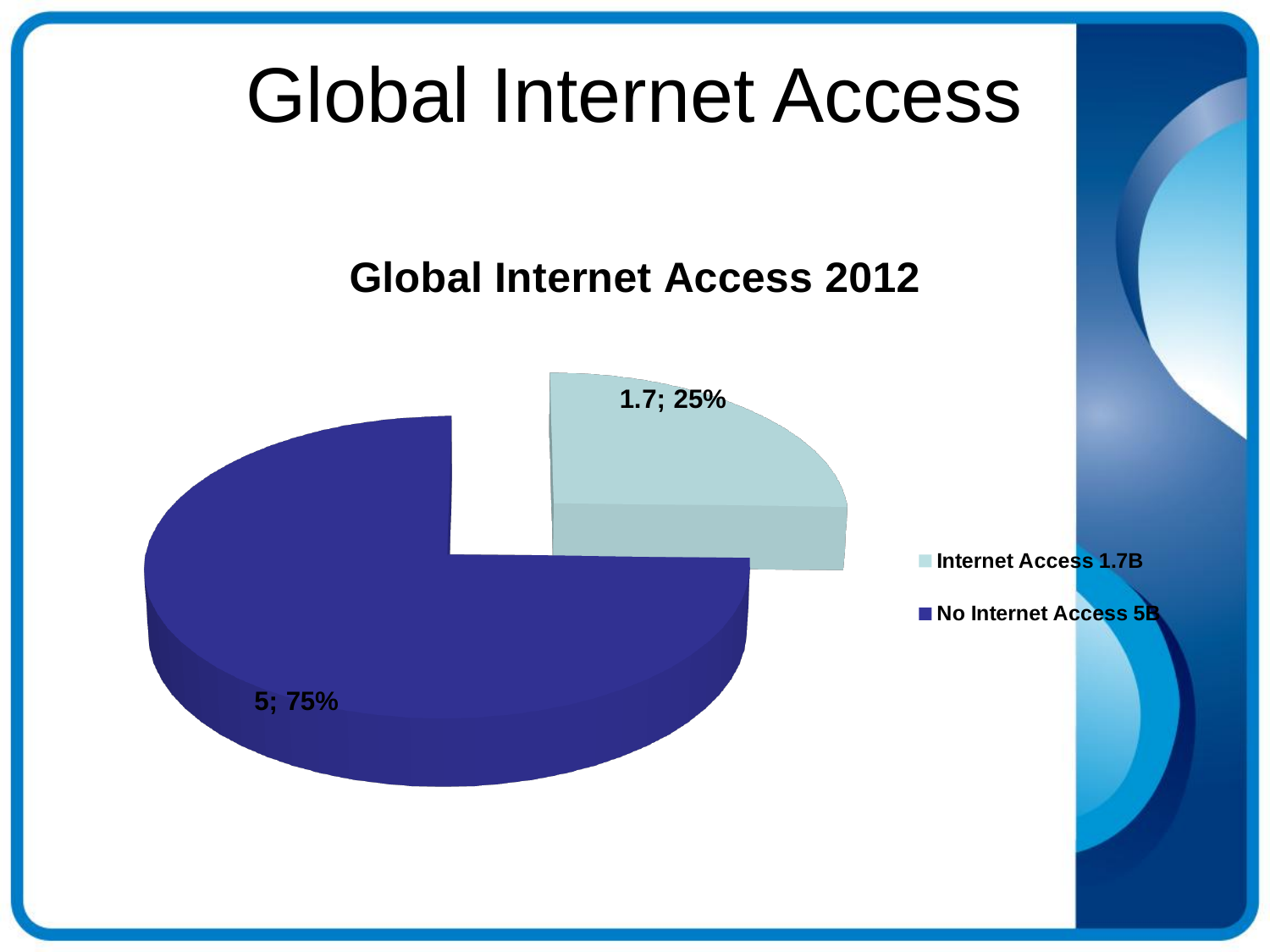
Which slice is the smallest? Internet Access What type of chart is shown on the slide? Pie chart What share of the pie does the No Internet Access slice represent? 75% What is the title of the chart? Global Internet Access 2012 How many entries does the legend list? 2 Which is larger, the Internet Access slice or the No Internet Access slice? No Internet Access How many slices does the pie chart have? 2 Which slice is the largest? No Internet Access What share of the pie does the Internet Access slice represent? 25% What value is shown for the Internet Access slice? 1.7 What is the difference between the No Internet Access value and the Internet Access value? 3.3 What value is shown for the No Internet Access slice? 5